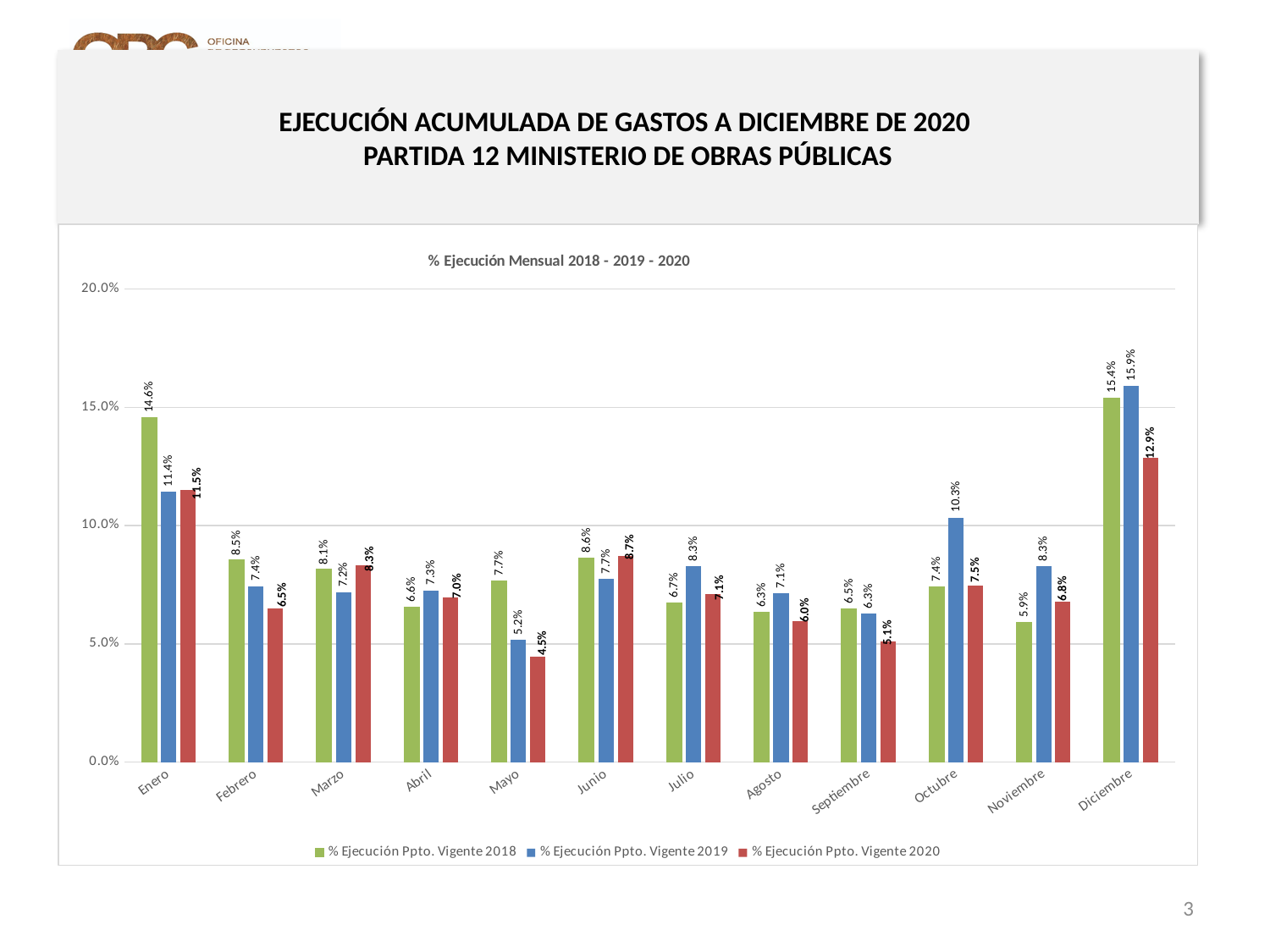
What is the value for % Ejecución Ppto. Vigente 2019 in Octubre? 10.3% Which month has the highest value for % Ejecución Ppto. Vigente 2019? Diciembre Is the value for % Ejecución Ppto. Vigente 2018 in Diciembre greater or less than 15.0%? greater Which is larger in Noviembre: the 2018 value or the 2019 value? 2019 What is the value for % Ejecución Ppto. Vigente 2020 in Diciembre? 12.9% How many series does the legend list? 3 What is the difference between the 2019 and 2020 values in Mayo? 0.7% What is the title of the chart? % Ejecución Mensual 2018 - 2019 - 2020 What is the value for % Ejecución Ppto. Vigente 2018 in Enero? 14.6% Which month has the lowest value for % Ejecución Ppto. Vigente 2020? Mayo What kind of chart is shown on the slide? Bar chart How many months are shown on the x axis? 12